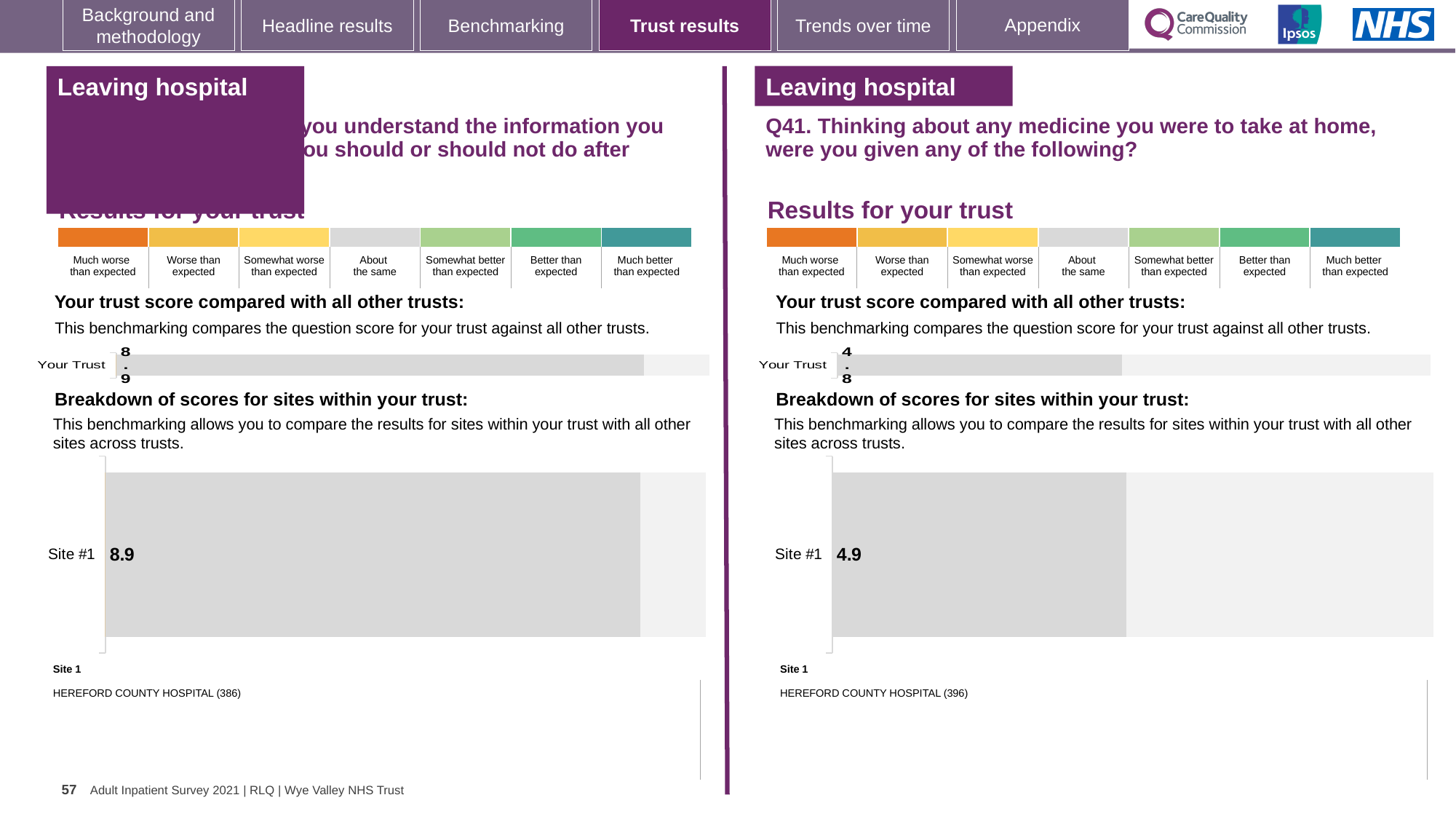
On the left-hand chart, what is the score shown for Your Trust? 8.9 What is the difference between the Your Trust score on the left-hand chart and the Your Trust score on the right-hand chart (Q41)? 4.1 How many sites are shown in the site breakdown on the left-hand chart? 1 On the right-hand chart (Q41), which site is listed as Site 1? HEREFORD COUNTY HOSPITAL (396) On the left-hand chart, what is the score shown for Site #1? 8.9 On the left-hand chart, which site is listed as Site 1? HEREFORD COUNTY HOSPITAL (386) On the right-hand chart (Q41), what is the score shown for Site #1? 4.9 On the right-hand chart (Q41), what is the difference between the Site #1 score and the Your Trust score? 0.1 On the right-hand chart (Q41), what is the score shown for Your Trust? 4.8 What type of chart is used to show the Site #1 score on the right-hand chart (Q41)? Bar chart Which is larger: the Site #1 score on the left-hand chart or the Site #1 score on the right-hand chart (Q41)? Left-hand chart (8.9)